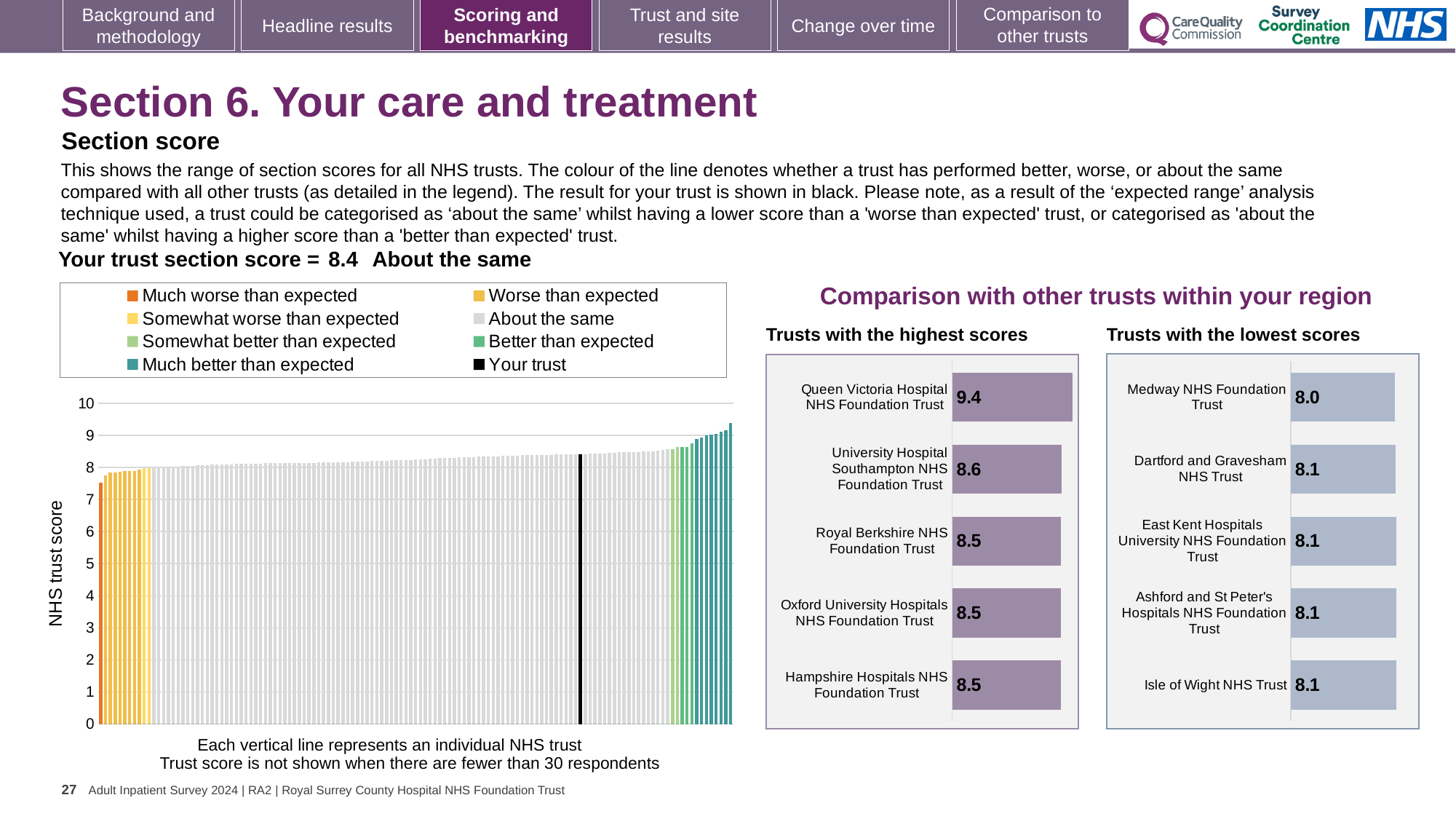
In the 'Trusts with the highest scores' chart, what is the score for Queen Victoria Hospital NHS Foundation Trust? 9.4 How many trusts are shown in the 'Trusts with the lowest scores' chart? 5 How many entries does the legend of the 'NHS trust score' chart on the left list? 8 In the 'Trusts with the lowest scores' chart, what is the difference between the scores of Isle of Wight NHS Trust and Medway NHS Foundation Trust? 0.1 In the 'Trusts with the lowest scores' chart, what is the score for Medway NHS Foundation Trust? 8.0 In the 'Trusts with the highest scores' chart, what is the score for University Hospital Southampton NHS Foundation Trust? 8.6 In the 'Trusts with the highest scores' chart, which trust has the highest score? Queen Victoria Hospital NHS Foundation Trust What kind of chart is the 'Trusts with the highest scores' chart? Bar chart Which is larger: the score for Queen Victoria Hospital NHS Foundation Trust in the 'Trusts with the highest scores' chart, or the score for Medway NHS Foundation Trust in the 'Trusts with the lowest scores' chart? Queen Victoria Hospital NHS Foundation Trust In the 'Trusts with the highest scores' chart, what is the difference between the scores of Queen Victoria Hospital NHS Foundation Trust and University Hospital Southampton NHS Foundation Trust? 0.8 In the 'NHS trust score' chart on the left, do the bars rise or fall from left to right? Rise In the 'Trusts with the lowest scores' chart, which trust has the lowest score? Medway NHS Foundation Trust